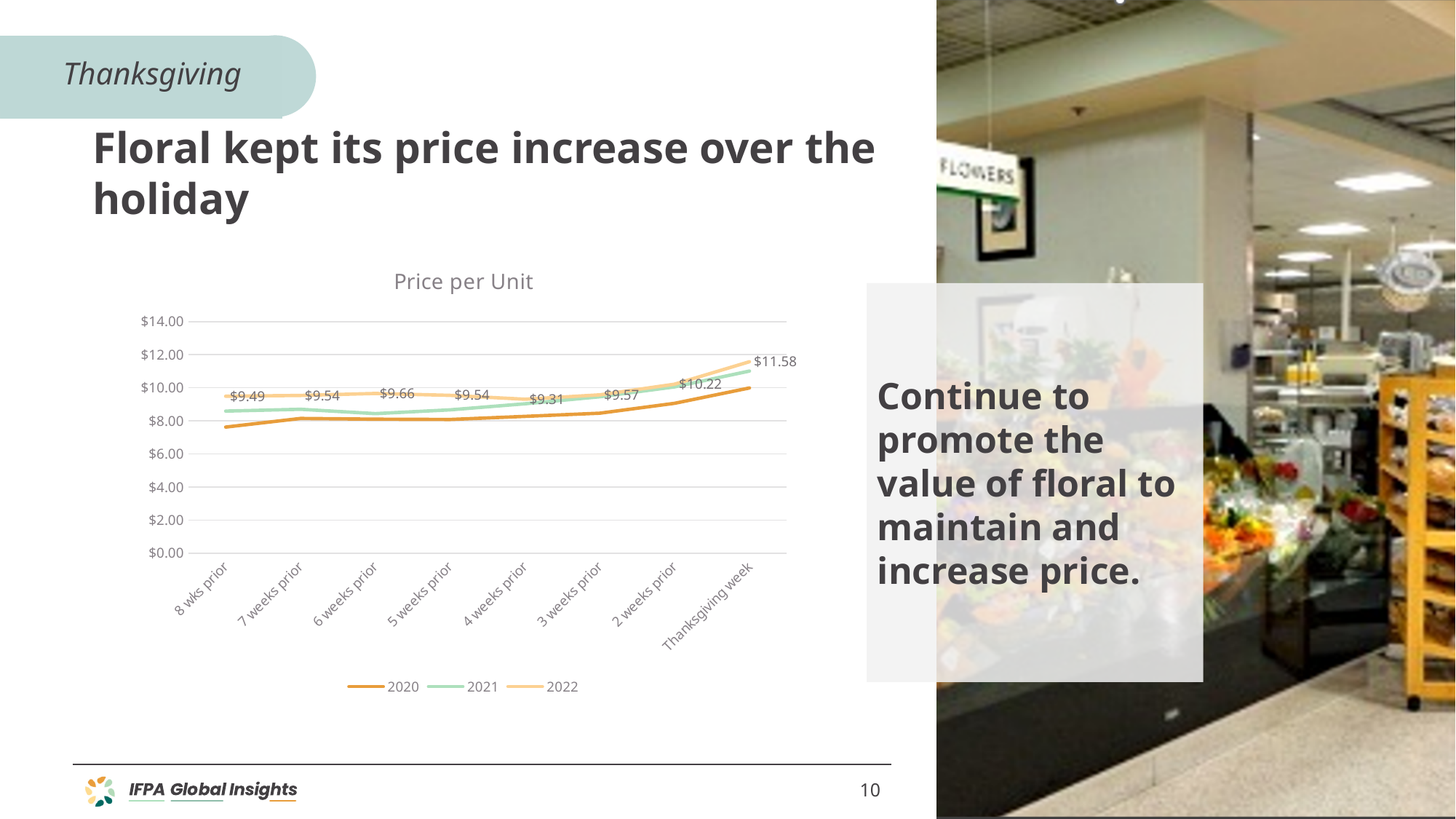
What kind of chart is shown on the slide? line chart Is the 2020 price per unit at 8 wks prior greater or less than $8.00? less What is the 2022 price per unit at 8 wks prior? $9.49 At which time point is the 2022 price per unit lowest? 4 weeks prior What is the 2022 price per unit for Thanksgiving week? $11.58 At which time point is the 2022 price per unit highest? Thanksgiving week What is the 2022 price per unit at 4 weeks prior? $9.31 How many time points are plotted along the x axis? 8 What is the difference between the 2022 price per unit in Thanksgiving week and at 2 weeks prior? $1.36 How many series does the chart legend list? 3 What is the title of the chart? Price per Unit What is the 2022 price per unit at 2 weeks prior? $10.22